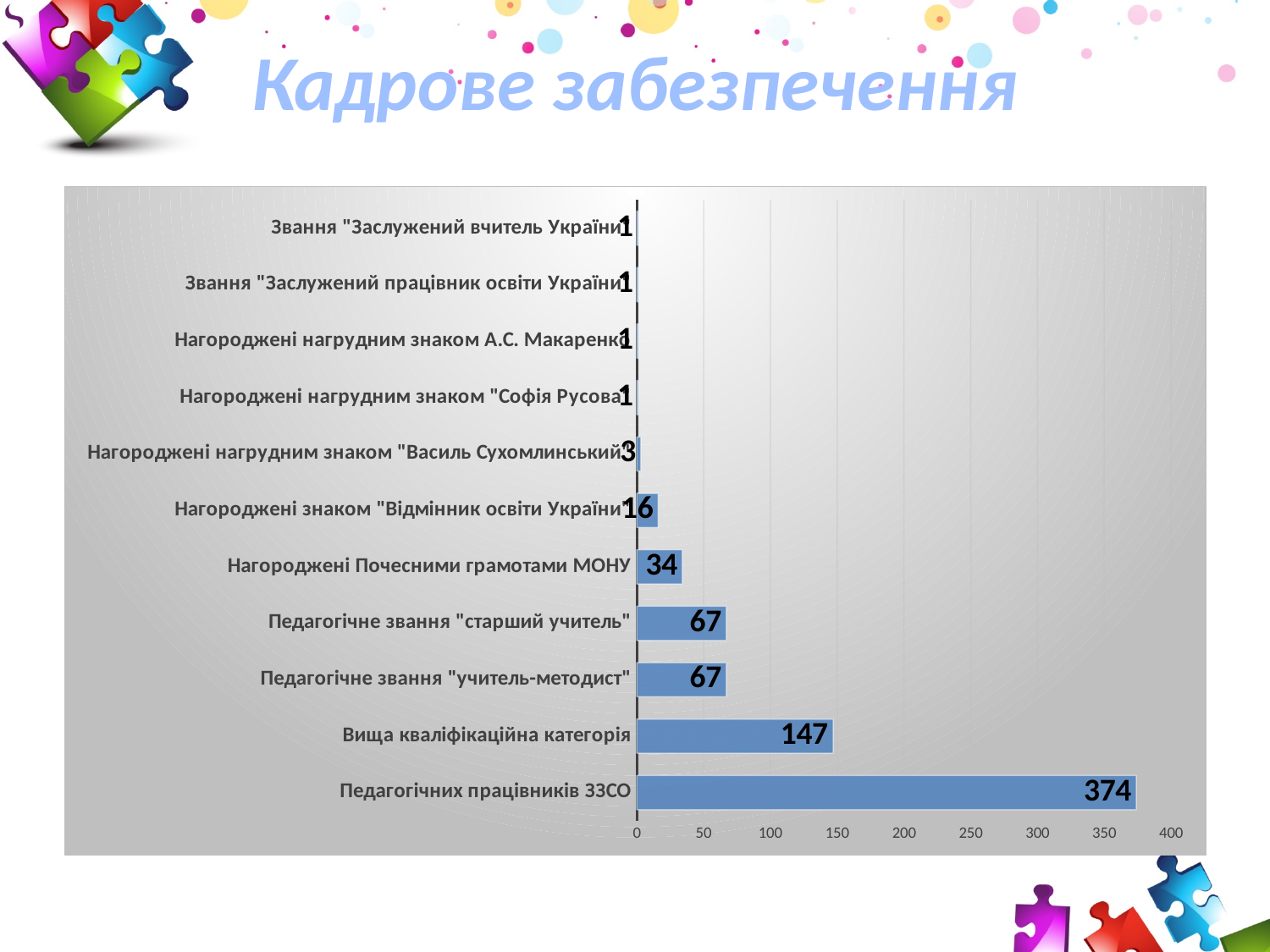
What is the value for "Вища кваліфікаційна категорія"? 147 What kind of chart is shown on the slide? Bar chart What is the value for "Нагороджені Почесними грамотами МОНУ"? 34 Which is larger: the value for "Вища кваліфікаційна категорія" or the value for "Педагогічне звання "учитель-методист"? Вища кваліфікаційна категорія What is the difference between the values for "Педагогічних працівників ЗЗСО" and "Вища кваліфікаційна категорія"? 227 What is the difference between the values for "Педагогічне звання "старший учитель" and "Нагороджені Почесними грамотами МОНУ"? 33 How many categories are shown in the chart? 11 What is the value for "Педагогічних працівників ЗЗСО"? 374 Which category has the highest value? Педагогічних працівників ЗЗСО What is the value for "Нагороджені нагрудним знаком "Василь Сухомлинський"? 3 What is the value for "Нагороджені знаком "Відмінник освіти України"? 16 What is the title of the slide? Кадрове забезпечення